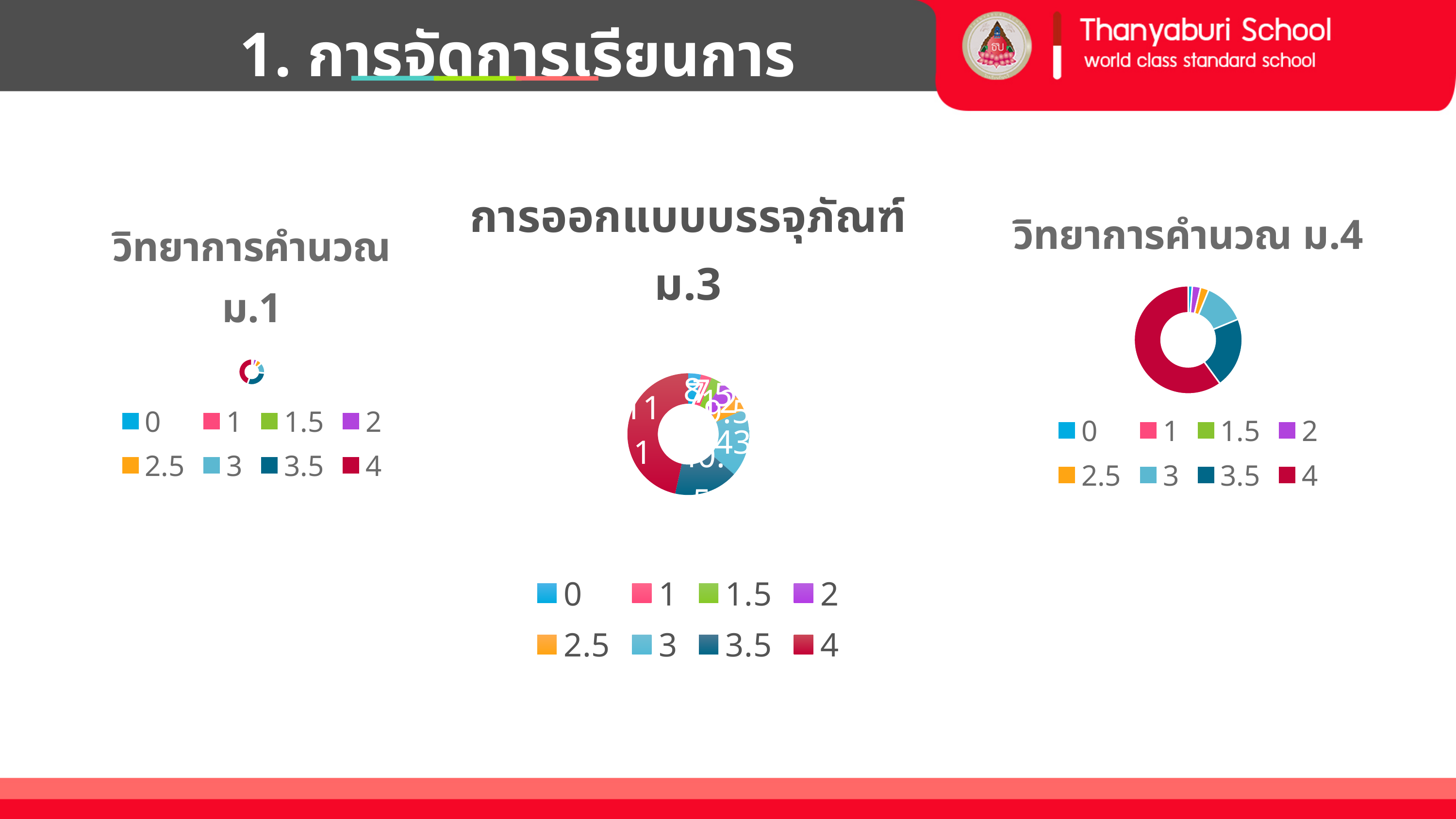
How many entries does the legend of the "วิทยาการคำนวณ ม.4" chart list? 8 In the legend of the "วิทยาการคำนวณ ม.4" chart, which category is shown in dark red? 4 In the "การออกแบบบรรจุภัณฑ์ ม.3" chart, which slice is larger, 4 or 3.5? 4 In the "วิทยาการคำนวณ ม.4" chart, which slice is larger, 4 or 3.5? 4 How many entries does the legend of the "การออกแบบบรรจุภัณฑ์ ม.3" chart list? 8 What kind of chart is shown under the title "วิทยาการคำนวณ ม.4"? Doughnut chart In the "วิทยาการคำนวณ ม.4" chart, which slice is larger, 3.5 or 3? 3.5 In the "วิทยาการคำนวณ ม.4" chart, which category has the largest slice? 4 In the "การออกแบบบรรจุภัณฑ์ ม.3" chart, which category has the largest slice? 4 What kind of chart is shown under the title "วิทยาการคำนวณ ม.1"? Doughnut chart What is the title of the chart in the middle of the slide? การออกแบบบรรจุภัณฑ์ ม.3